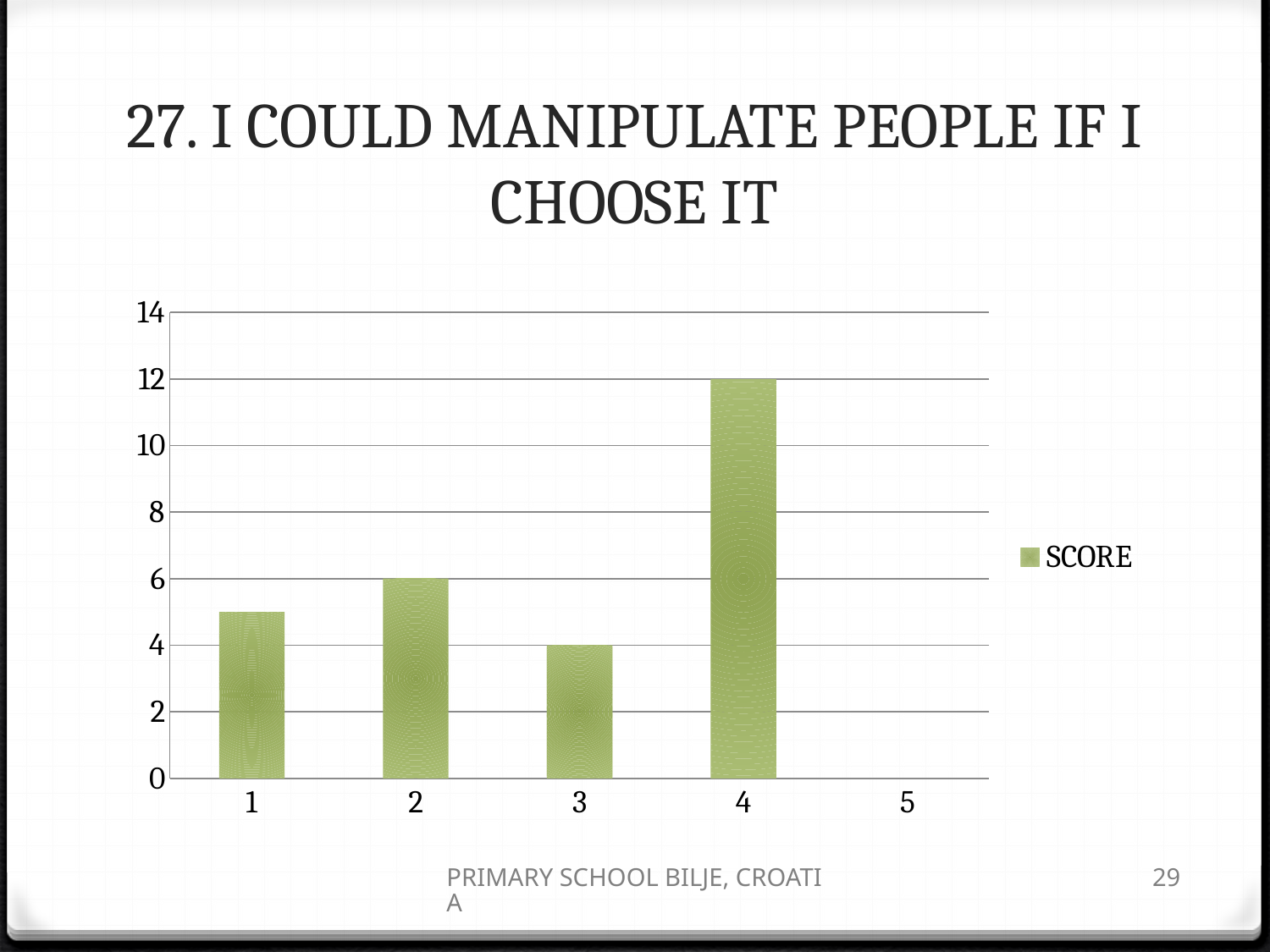
Which category has the lowest SCORE? 5 What is the SCORE value for category 4? 12 What is the SCORE value for category 2? 6 Which category has the highest SCORE? 4 What is the SCORE value for category 5? 0 What type of chart is shown on the slide? bar chart Is the SCORE for category 1 greater or less than 4? greater How many categories are shown on the x axis? 5 Which has a larger SCORE, category 2 or category 3? 2 What is the SCORE value for category 3? 4 How many series does the legend list? 1 What is the difference between the SCORE for category 4 and category 3? 8